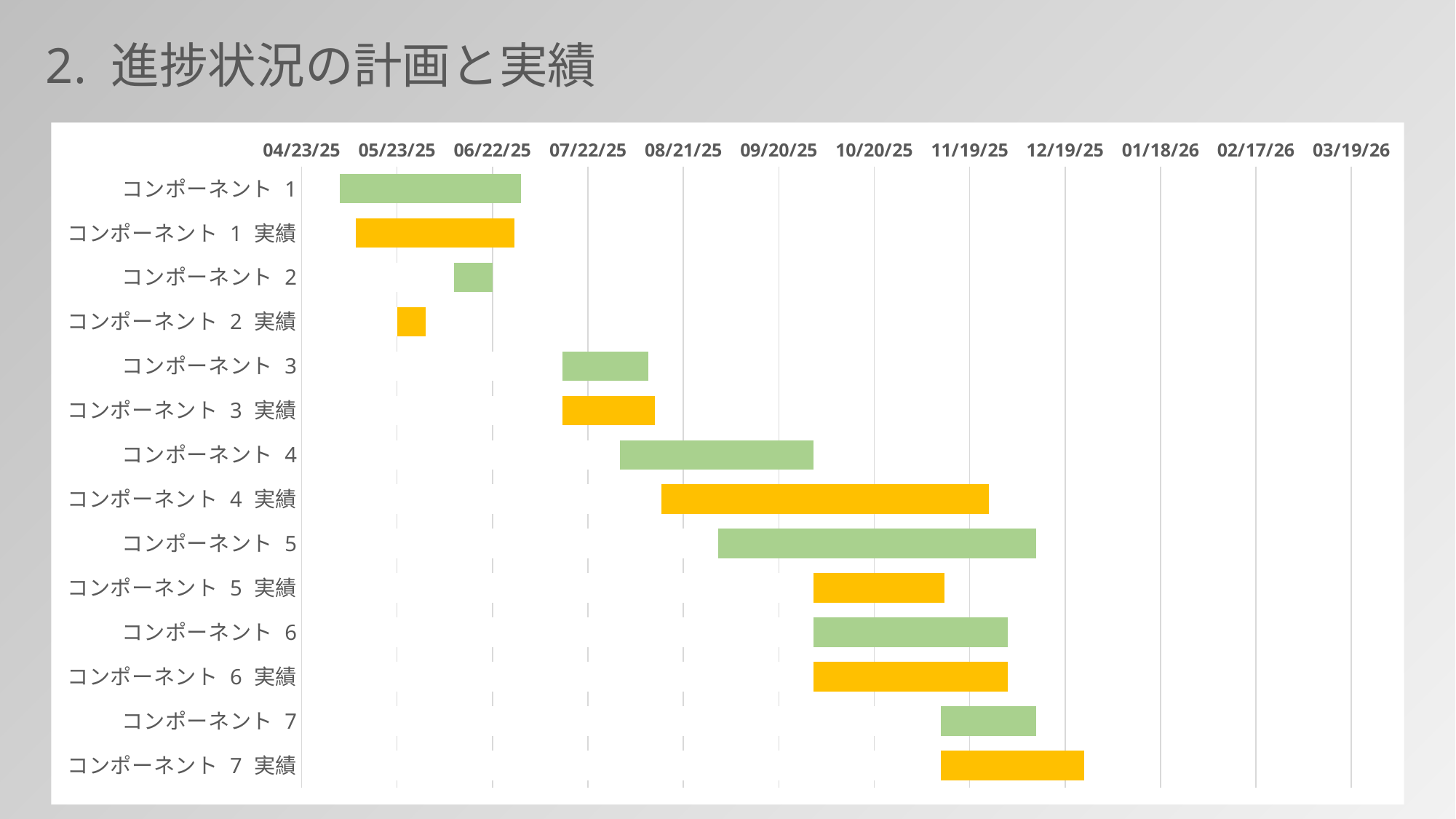
Does the bar for コンポーネント 7 実績 end before or after 12/19/25? after How many date labels are shown along the horizontal axis of the chart? 12 Does the bar for コンポーネント 5 実績 start before or after 09/20/25? after What is the first date label on the horizontal axis? 04/23/25 Which bar is longer, コンポーネント 4 or コンポーネント 4 実績? コンポーネント 4 実績 What kind of chart is shown on the slide? Bar chart (Gantt chart) How many rows (categories) are listed on the vertical axis of the chart? 14 Which row has the shortest bar in the chart? コンポーネント 2 実績 Which bar is longer, コンポーネント 7 or コンポーネント 7 実績? コンポーネント 7 実績 What is the last date label on the horizontal axis? 03/19/26 Does the bar for コンポーネント 1 start before or after 05/23/25? before Which bar is longer, コンポーネント 2 or コンポーネント 2 実績? コンポーネント 2